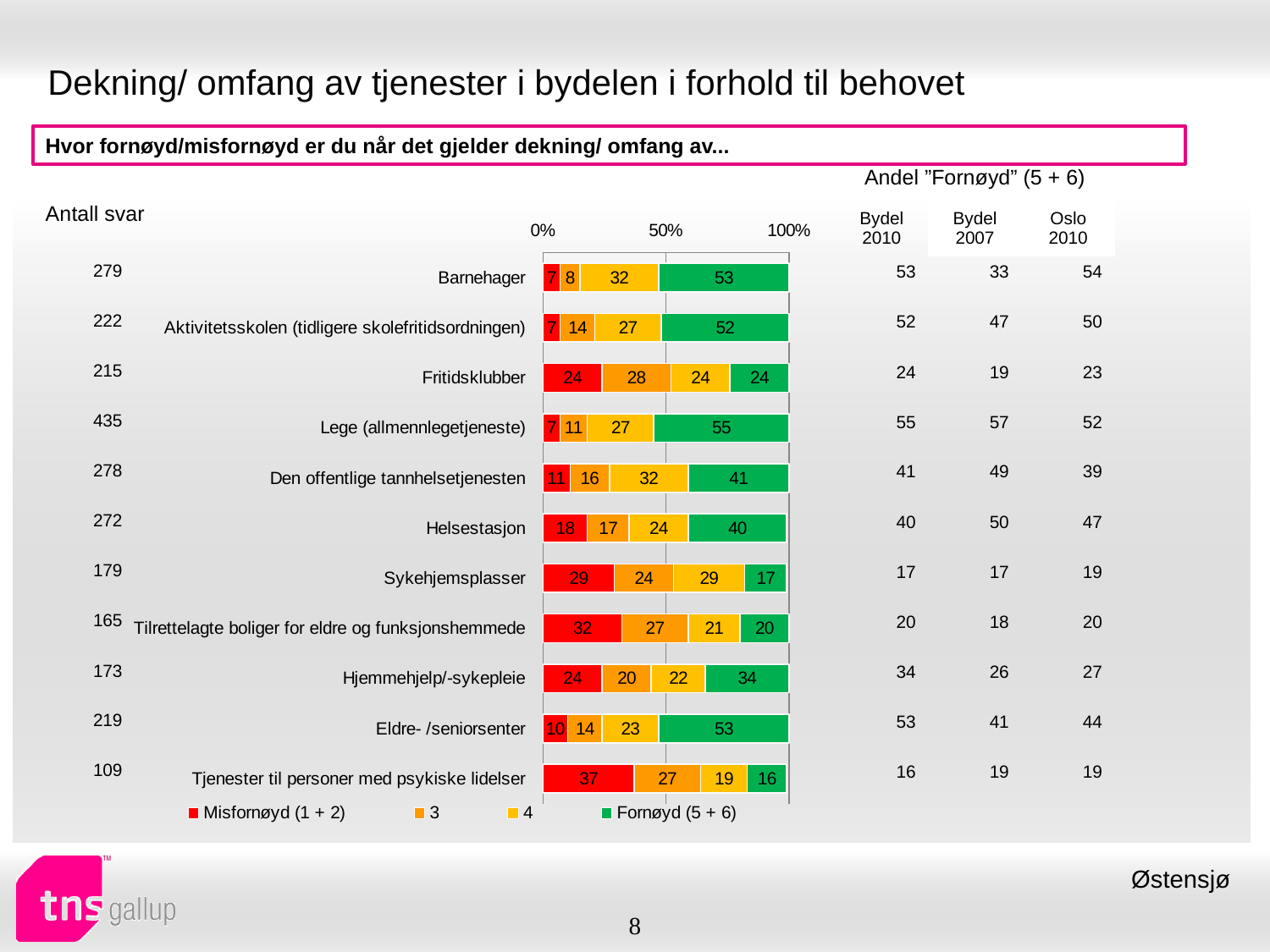
What is the total of the stacked bar for Barnehager? 100 How many categories are shown in the bar chart? 11 What is the difference between the Misfornøyd (1 + 2) values for Tjenester til personer med psykiske lidelser and Sykehjemsplasser? 8 What is the value of the Misfornøyd (1 + 2) segment for Tjenester til personer med psykiske lidelser? 37 What is the value of the '3' segment for Fritidsklubber? 28 What is the value of the Fornøyd (5 + 6) segment for Lege (allmennlegetjeneste)? 55 Which category has the highest Fornøyd (5 + 6) value? Lege (allmennlegetjeneste) How many series does the legend list? 4 Which is larger: the Fornøyd (5 + 6) value for Hjemmehjelp/-sykepleie or for Helsestasjon? Helsestasjon Which category has the lowest Misfornøyd (1 + 2) value? Barnehager, Aktivitetsskolen and Lege (allmennlegetjeneste), all at 7 Which category has the highest Misfornøyd (1 + 2) value? Tjenester til personer med psykiske lidelser What kind of chart is shown on the slide? Stacked bar chart